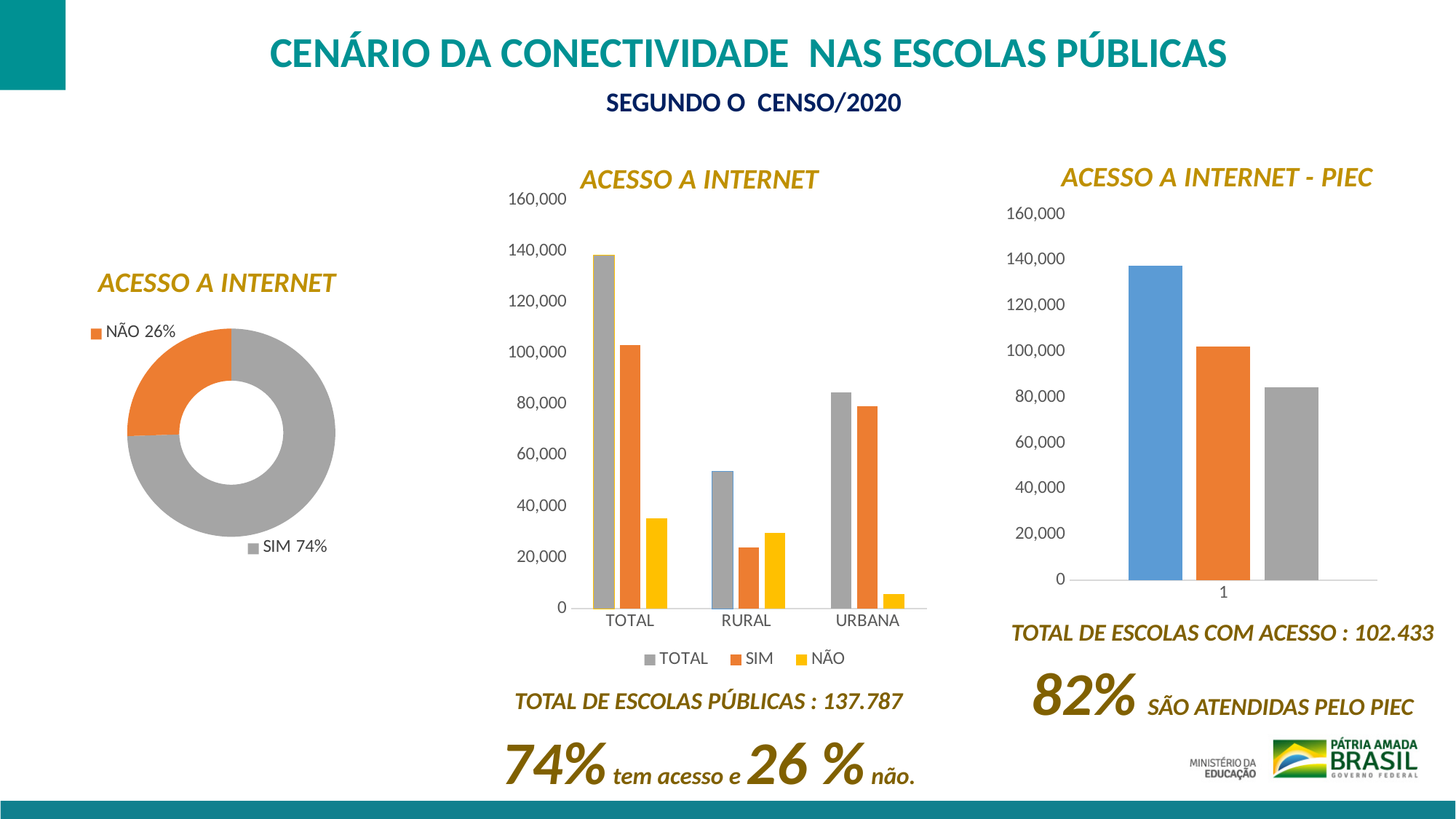
In the middle bar chart titled ACESSO A INTERNET, is the TOTAL value for the TOTAL category greater or less than 120,000? greater In the donut chart titled ACESSO A INTERNET on the left, what share of schools is labelled SIM? 74% In the middle bar chart titled ACESSO A INTERNET, which category has the lowest NÃO value? URBANA In the right bar chart titled ACESSO A INTERNET - PIEC, which bar is the shortest: blue, orange or gray? gray What kind of chart is the middle chart titled ACESSO A INTERNET? Bar chart How many series does the legend of the middle bar chart titled ACESSO A INTERNET list? 3 How many categories are shown on the x axis of the middle bar chart titled ACESSO A INTERNET? 3 In the middle bar chart titled ACESSO A INTERNET, is the NÃO value for URBANA greater or less than 20,000? less In the middle bar chart titled ACESSO A INTERNET, which is larger for the RURAL category: SIM or NÃO? NÃO What kind of chart is the left chart titled ACESSO A INTERNET? Donut (pie) chart In the right bar chart titled ACESSO A INTERNET - PIEC, is the value of the blue bar greater or less than 120,000? greater In the donut chart titled ACESSO A INTERNET on the left, what share of schools is labelled NÃO? 26%